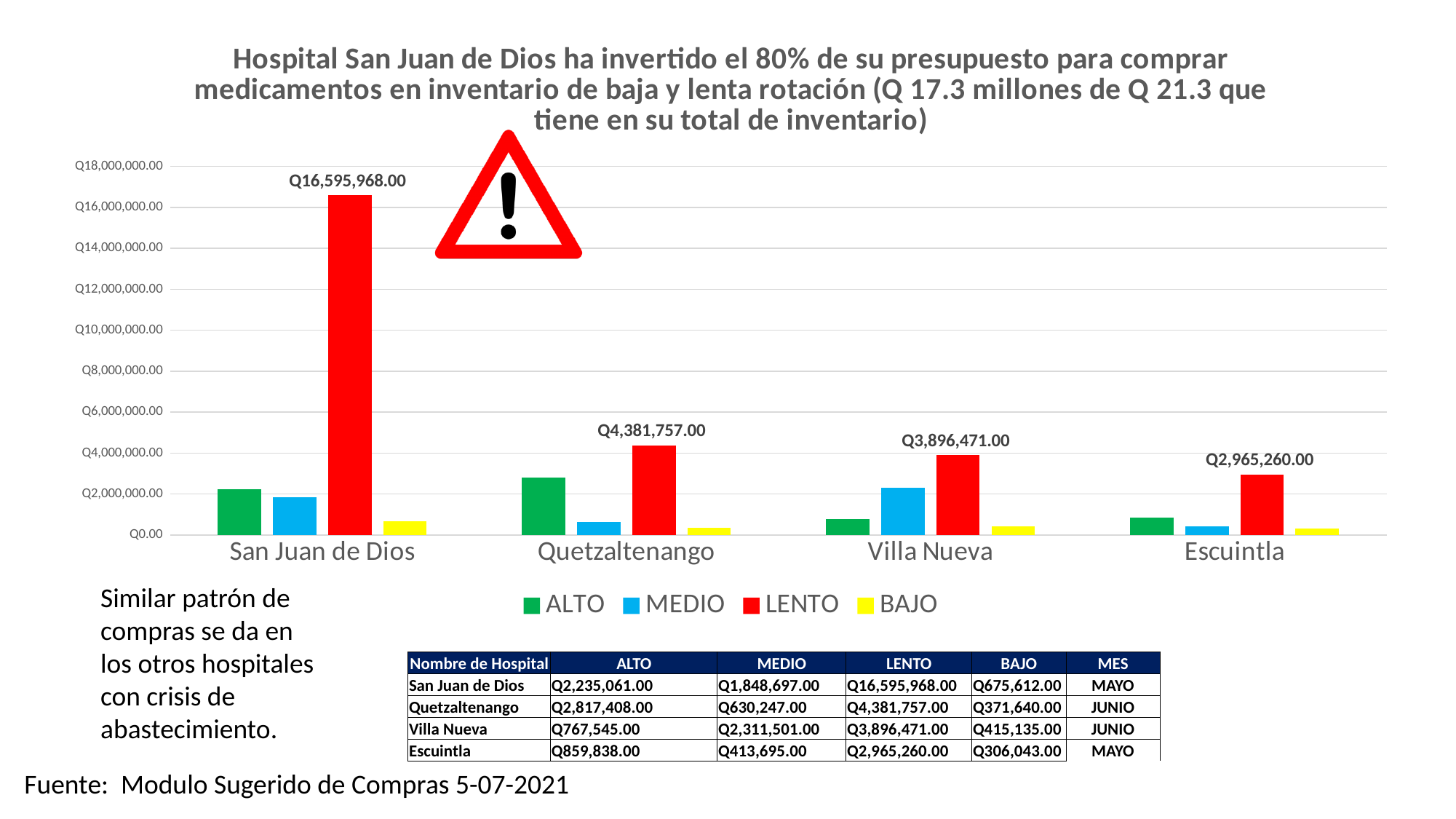
What kind of chart is shown on the slide? bar chart Is the ALTO value for Quetzaltenango greater or less than Q2,000,000.00? greater Which hospital has the highest LENTO value? San Juan de Dios How many hospitals are shown on the x axis of the chart? 4 What is the value of the LENTO bar for San Juan de Dios? Q16,595,968.00 What is the value of the LENTO bar for Escuintla? Q2,965,260.00 Which hospital has the lowest LENTO value? Escuintla Which is larger, the LENTO value for Villa Nueva or the LENTO value for Escuintla? Villa Nueva What is the difference between the LENTO values for San Juan de Dios and Quetzaltenango? Q12,214,211.00 What is the difference between the LENTO values for Villa Nueva and Escuintla? Q931,211.00 What is the value of the LENTO bar for Quetzaltenango? Q4,381,757.00 How many series does the chart legend list? 4